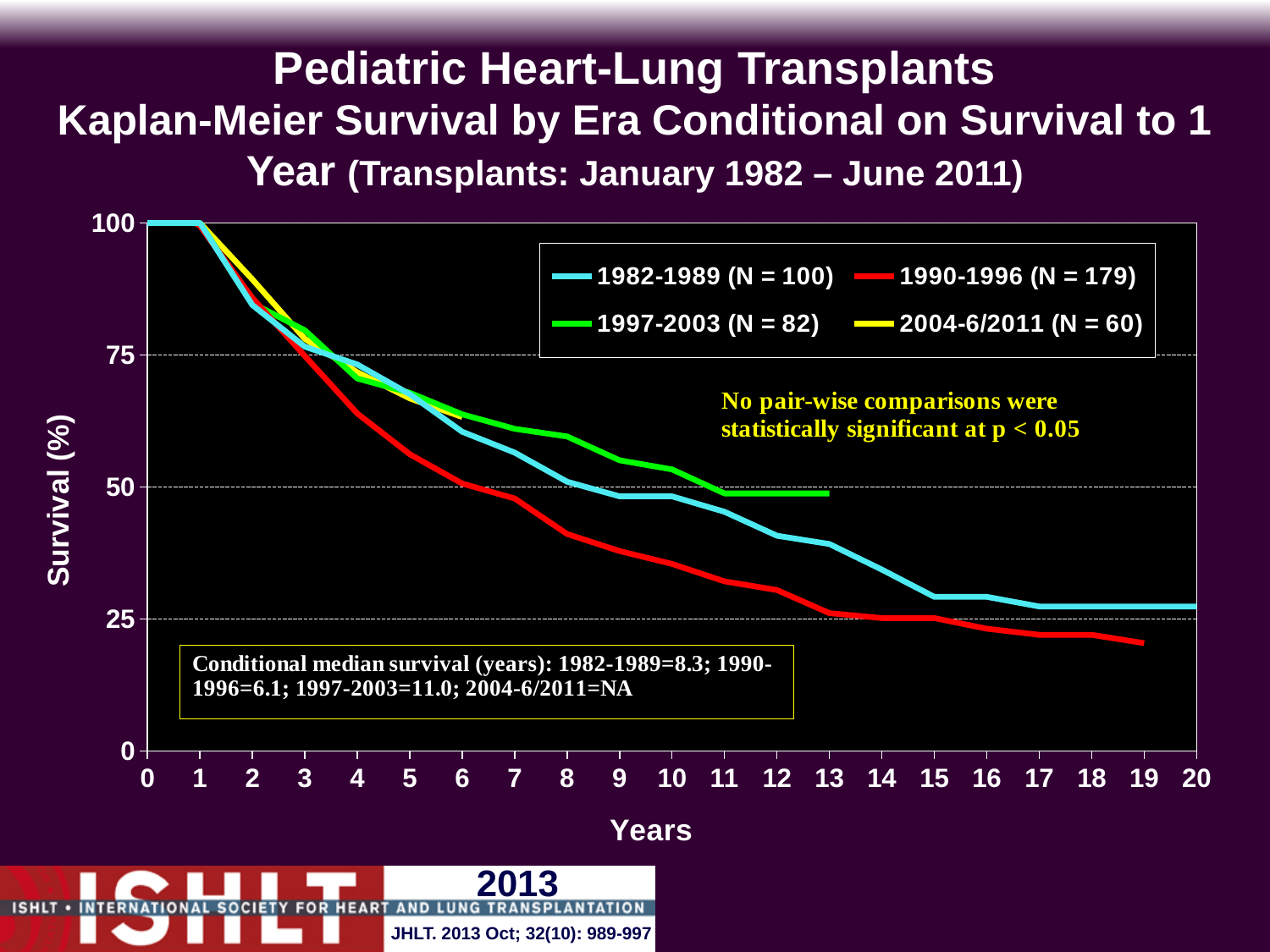
What is the conditional median survival in years for the 1997-2003 era? 11.0 Do the survival curves rise or fall as years increase along the x axis? fall Which colour is used for the 2004-6/2011 series? yellow At 8 years, which era has lower survival: 1982-1989 or 1990-1996? 1990-1996 Is the survival value for the 1990-1996 era at 19 years greater or less than 25? less Is the survival value for the 1997-2003 era at 8 years greater or less than 50? greater At 10 years, which era has higher survival: 1997-2003 or 1990-1996? 1997-2003 Is the survival value for the 1982-1989 era at 20 years greater or less than 25? greater How many series does the legend list? 4 What kind of chart is shown on the slide? line chart What is the N for the 1990-1996 era shown in the legend? 179